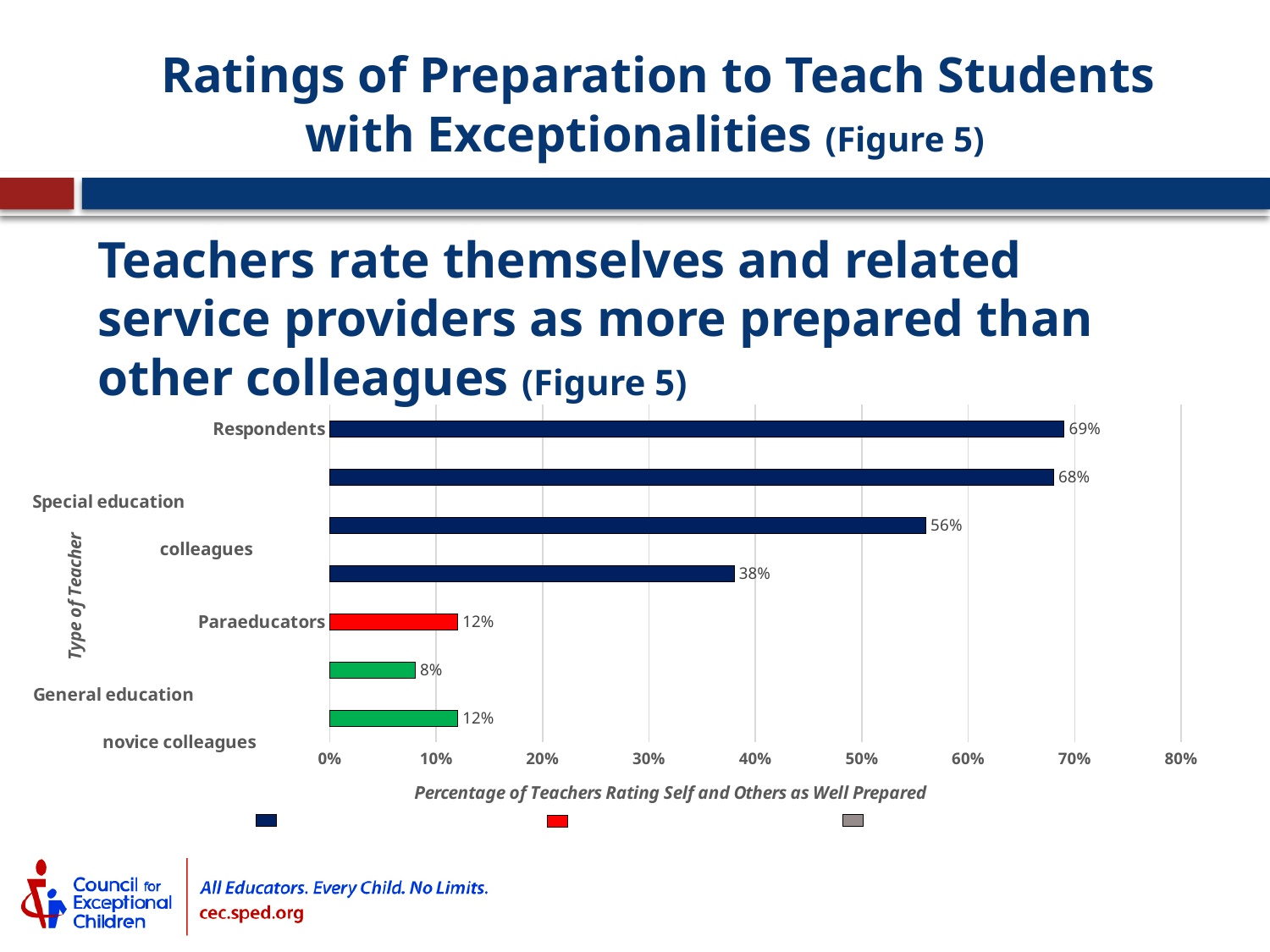
How many bars are plotted in the chart? 7 What percentage is shown for Respondents? 69% Which is larger, the value for Respondents or the value for Paraeducators? Respondents What percentage is shown for Paraeducators? 12% What is the highest value shown in the chart? 69% What is the lowest value shown in the chart? 8% What is the difference between the Respondents value and the Paraeducators value? 57 percentage points What is the title of the vertical axis? Type of Teacher Is the value for Respondents greater or less than 60%? greater Which category has the highest value in the chart? Respondents What is the title of the horizontal axis? Percentage of Teachers Rating Self and Others as Well Prepared What kind of chart is shown on the slide? Bar chart